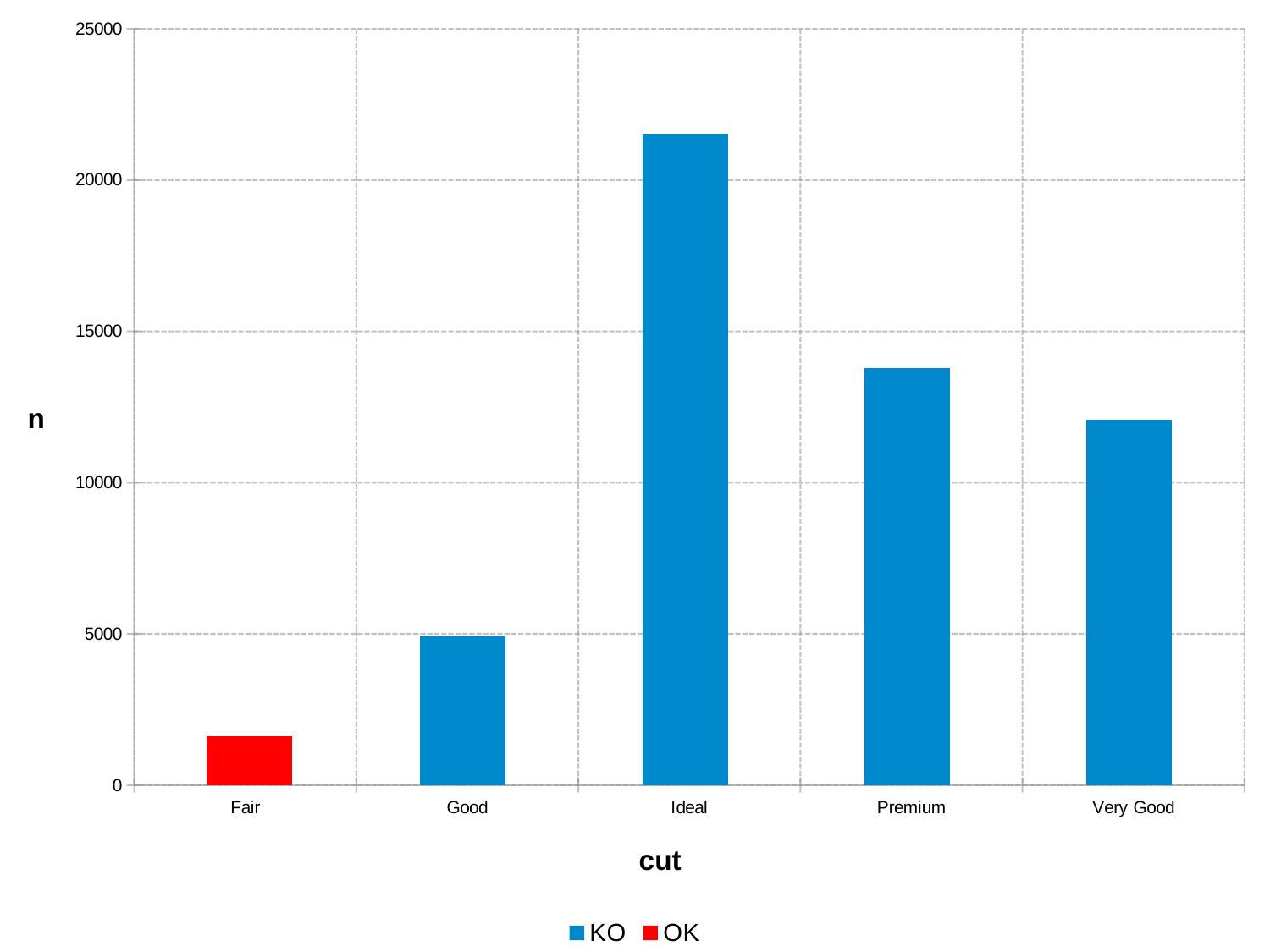
How many series does the legend list? 2 Is the value for Fair greater or less than 5000? less How many categories are shown on the x axis? 5 Is the value for Premium greater or less than 15000? less What kind of chart is shown on the slide? bar chart Which has a larger value of n, Good or Very Good? Very Good Which cut category has the lowest value of n? Fair Which cut category has the highest value of n? Ideal Which has a larger value of n, Premium or Very Good? Premium Is the value for Ideal greater or less than 20000? greater What is the label of the x axis? cut Which category is plotted in the OK series (red)? Fair